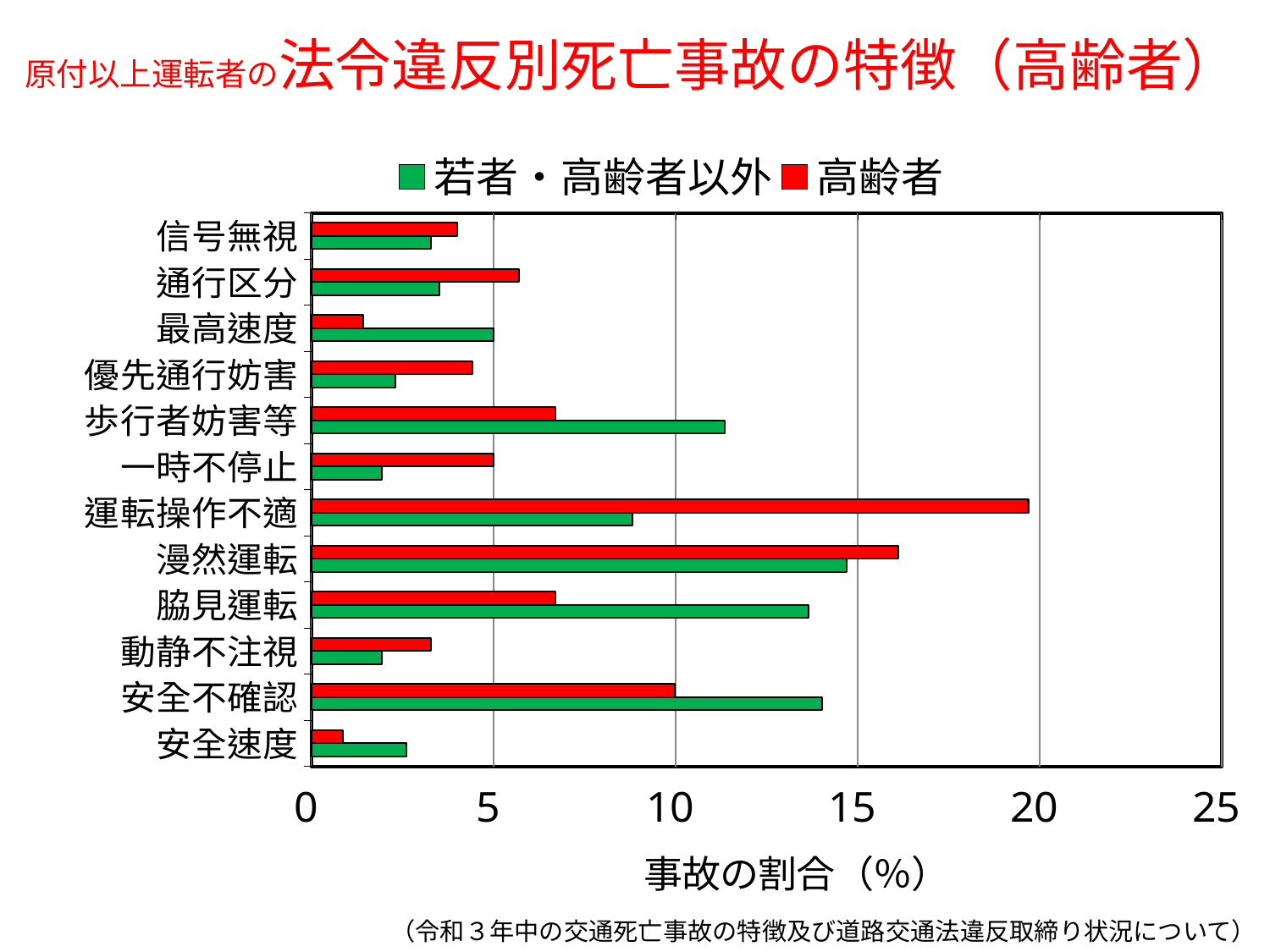
For 歩行者妨害等, which series has the larger value, 若者・高齢者以外 or 高齢者? 若者・高齢者以外 Is the value for 高齢者 in 運転操作不適 greater or less than 15? greater What kind of chart is shown on the slide? bar chart How many series does the legend list? 2 Which category has the highest value for 高齢者? 運転操作不適 Which category has the lowest value for 高齢者? 安全速度 What is the label of the x axis? 事故の割合（%） For 脇見運転, which series has the larger value, 若者・高齢者以外 or 高齢者? 若者・高齢者以外 Is the value for 若者・高齢者以外 in 安全不確認 greater or less than 10? greater For 運転操作不適, which series has the larger value, 若者・高齢者以外 or 高齢者? 高齢者 How many violation categories are plotted on the chart? 12 Is the value for 高齢者 in 安全速度 greater or less than 5? less